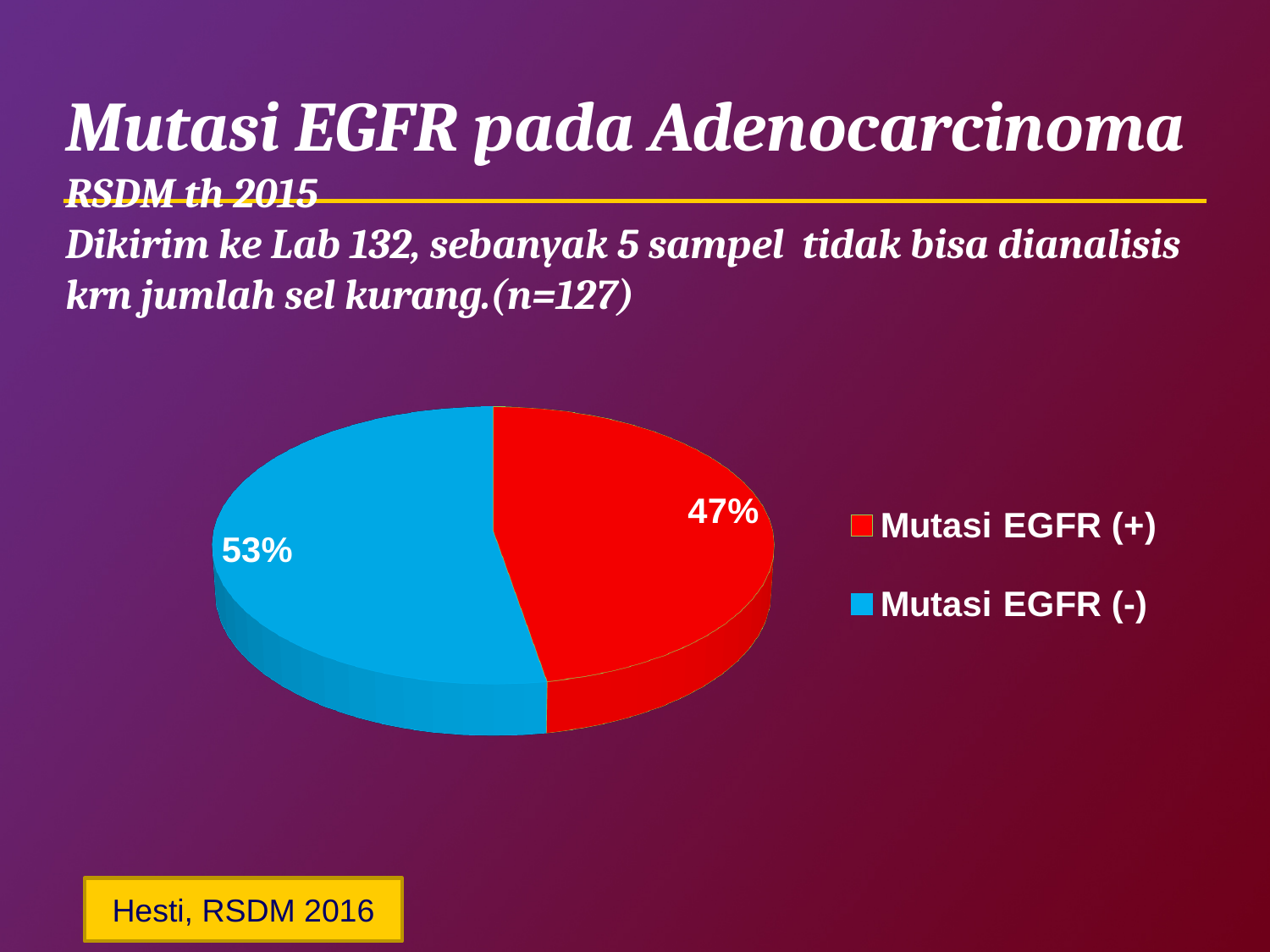
Which is larger, Mutasi EGFR (+) or Mutasi EGFR (-)? Mutasi EGFR (-) What percentage of the pie is Mutasi EGFR (-)? 53% What kind of chart is shown on the slide? pie chart What is the difference in percentage points between Mutasi EGFR (-) and Mutasi EGFR (+)? 6 How many entries does the legend list? 2 Which slice is the smallest? Mutasi EGFR (+) How many slices does the pie chart have? 2 What colour is the Mutasi EGFR (+) slice? red What colour is the Mutasi EGFR (-) slice? blue Which slice is the largest? Mutasi EGFR (-) What percentage of the pie is Mutasi EGFR (+)? 47%